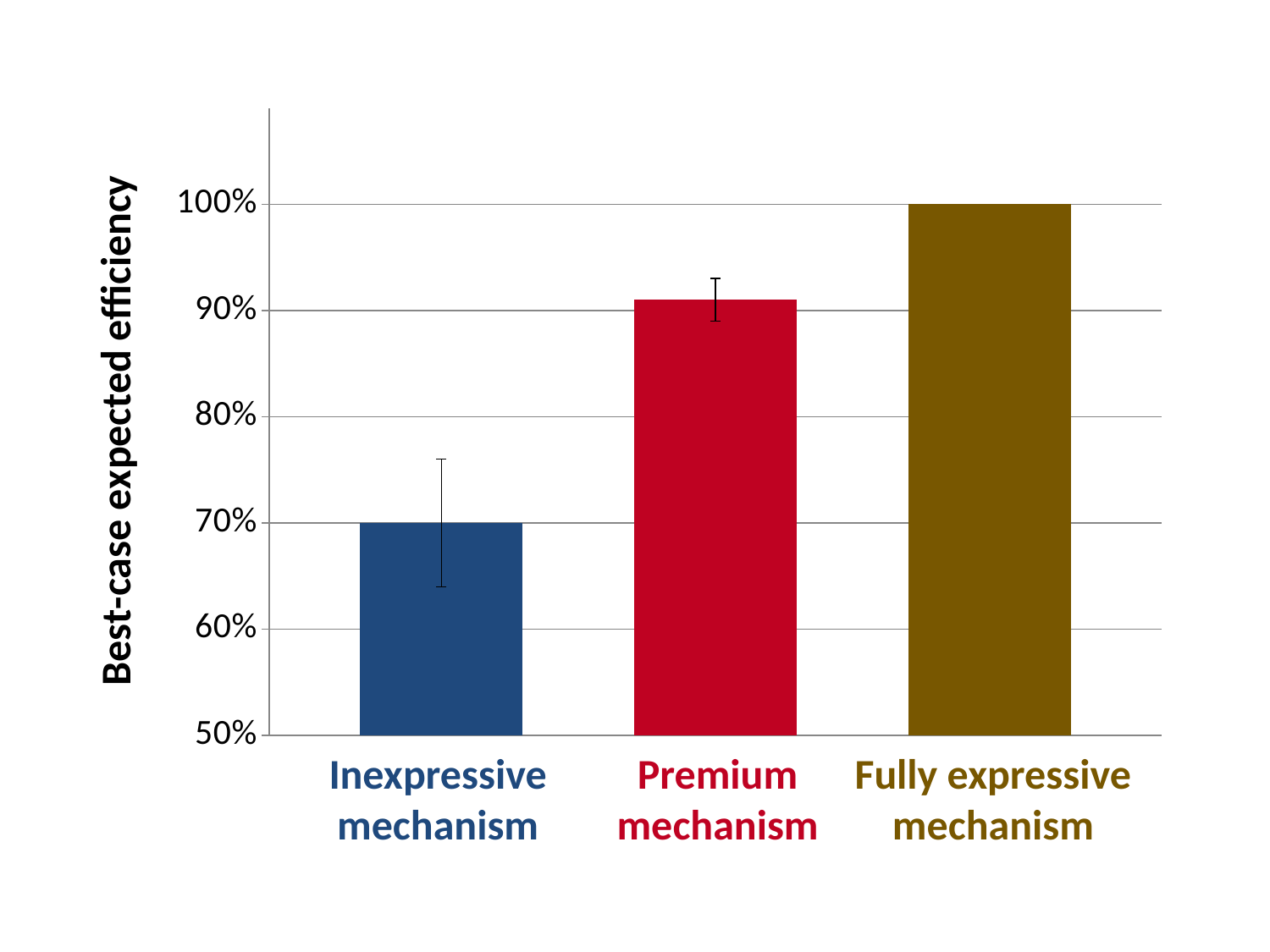
Which has a higher best-case expected efficiency, the Premium mechanism or the Inexpressive mechanism? Premium mechanism Is the value for the Inexpressive mechanism greater or less than 80%? less What is the best-case expected efficiency for the Fully expressive mechanism? 100% What is the best-case expected efficiency for the Inexpressive mechanism? 70% Do the values rise or fall moving from left to right across the categories? rise What is the label on the vertical axis of the chart? Best-case expected efficiency Which mechanism has the lowest best-case expected efficiency? Inexpressive mechanism Which mechanism has the highest best-case expected efficiency? Fully expressive mechanism What type of chart is shown on the slide? bar chart How many categories are plotted on the chart? 3 What is the difference in best-case expected efficiency between the Fully expressive mechanism and the Inexpressive mechanism? 30 percentage points